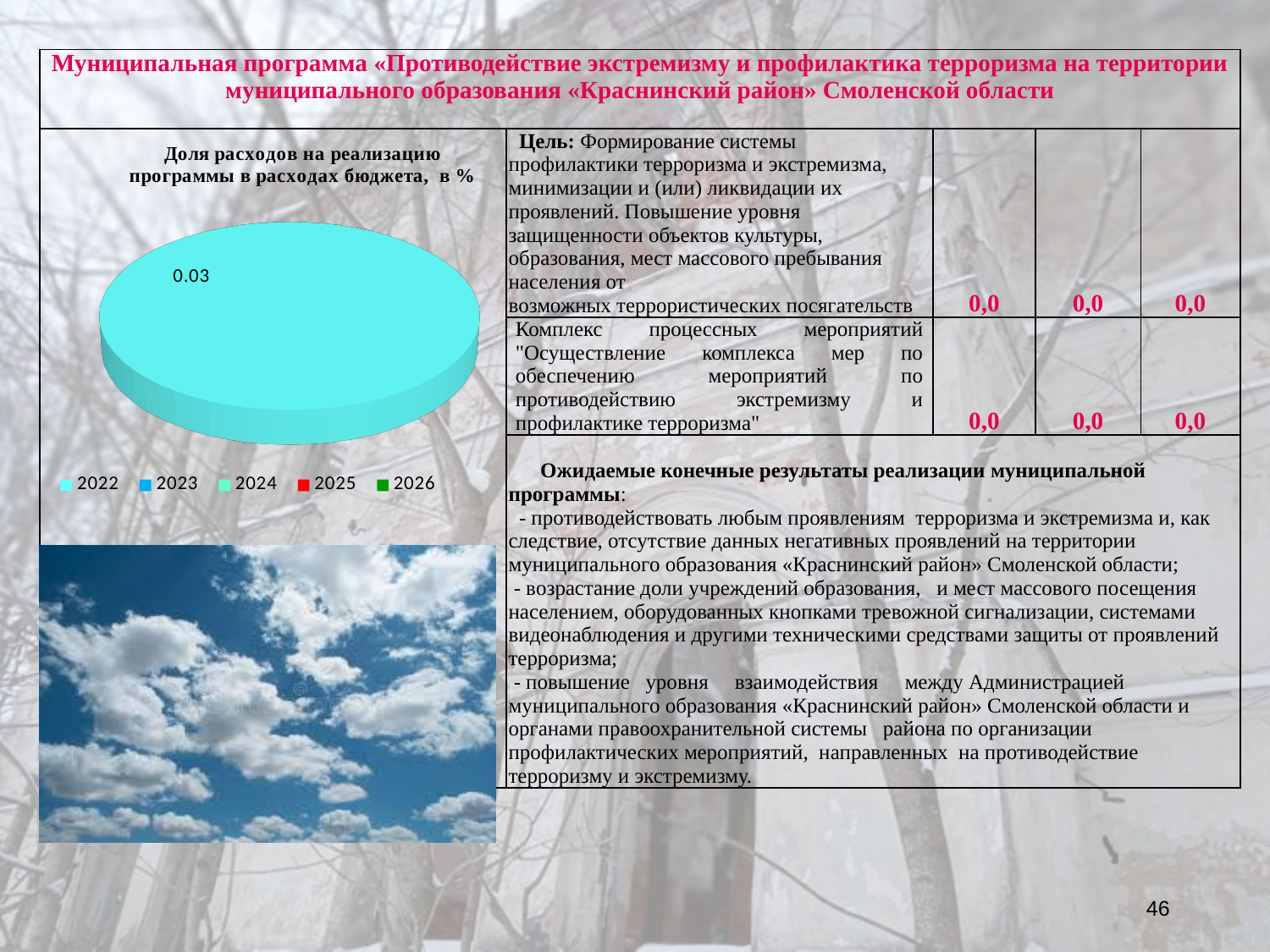
What kind of chart is shown on the slide? pie chart What value is printed as the data label on the pie chart? 0.03 What is the title of the chart on the slide? Доля расходов на реализацию программы в расходах бюджета, в % Which years are listed in the legend of the pie chart? 2022, 2023, 2024, 2025, 2026 How many slices are visible in the pie chart? 1 How many entries does the legend of the pie chart list? 5 Is the value labelled on the pie chart greater or less than 1? less